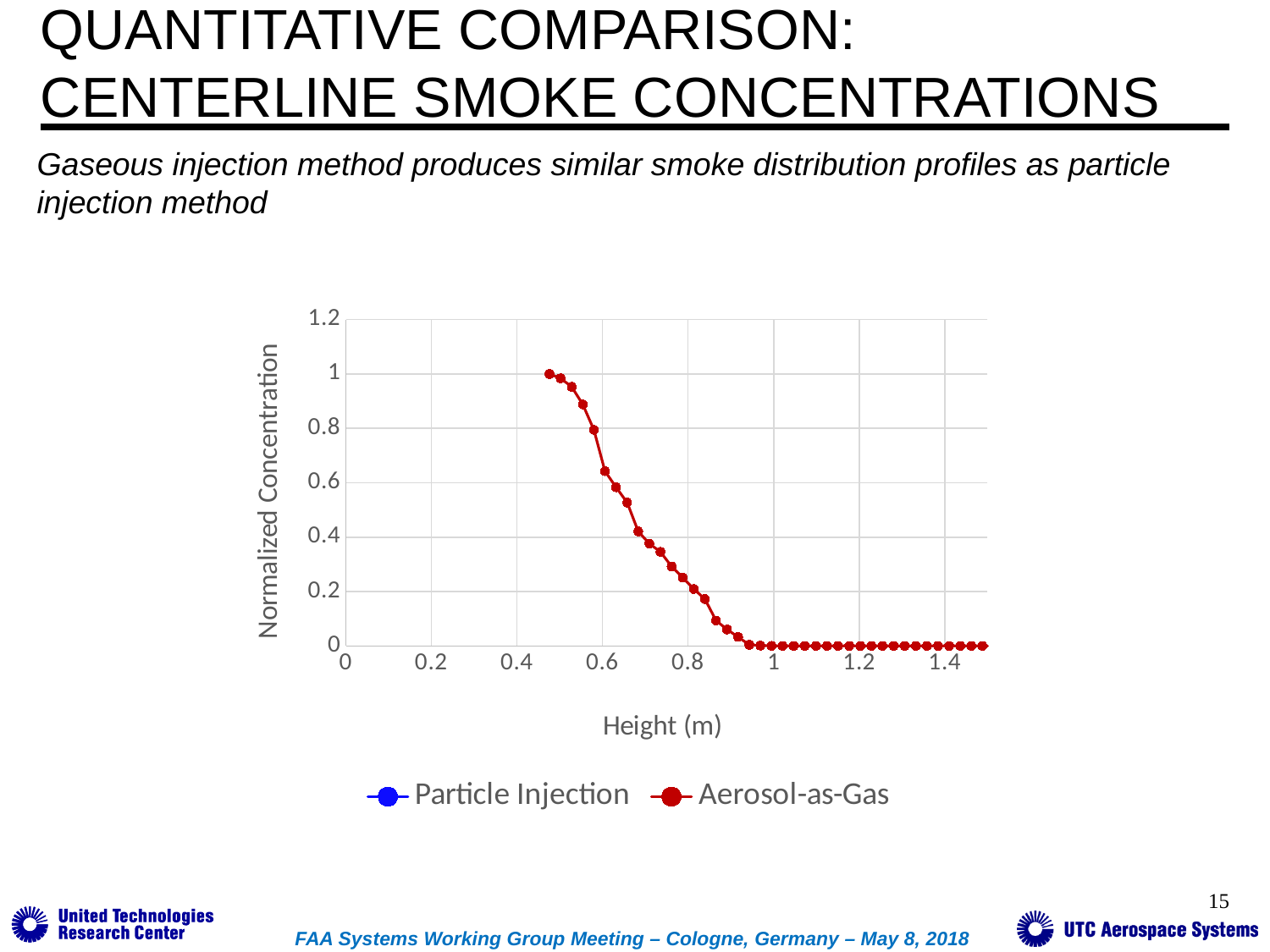
Is the normalized concentration at a height of 1.2 m greater or less than 0.2? less Is the normalized concentration at a height of 1.0 m greater or less than 0.2? less What is the label of the x axis? Height (m) Is the normalized concentration at a height of 0.5 m greater or less than 0.8? greater What are the two series named in the legend? Particle Injection and Aerosol-as-Gas What is the highest tick value shown on the y axis? 1.2 What kind of chart is shown on the slide? line chart How many series does the legend list? 2 Does the normalized concentration rise or fall as height increases along the x axis? fall Which is larger, the normalized concentration at a height of 0.5 m or at a height of 0.9 m? 0.5 m